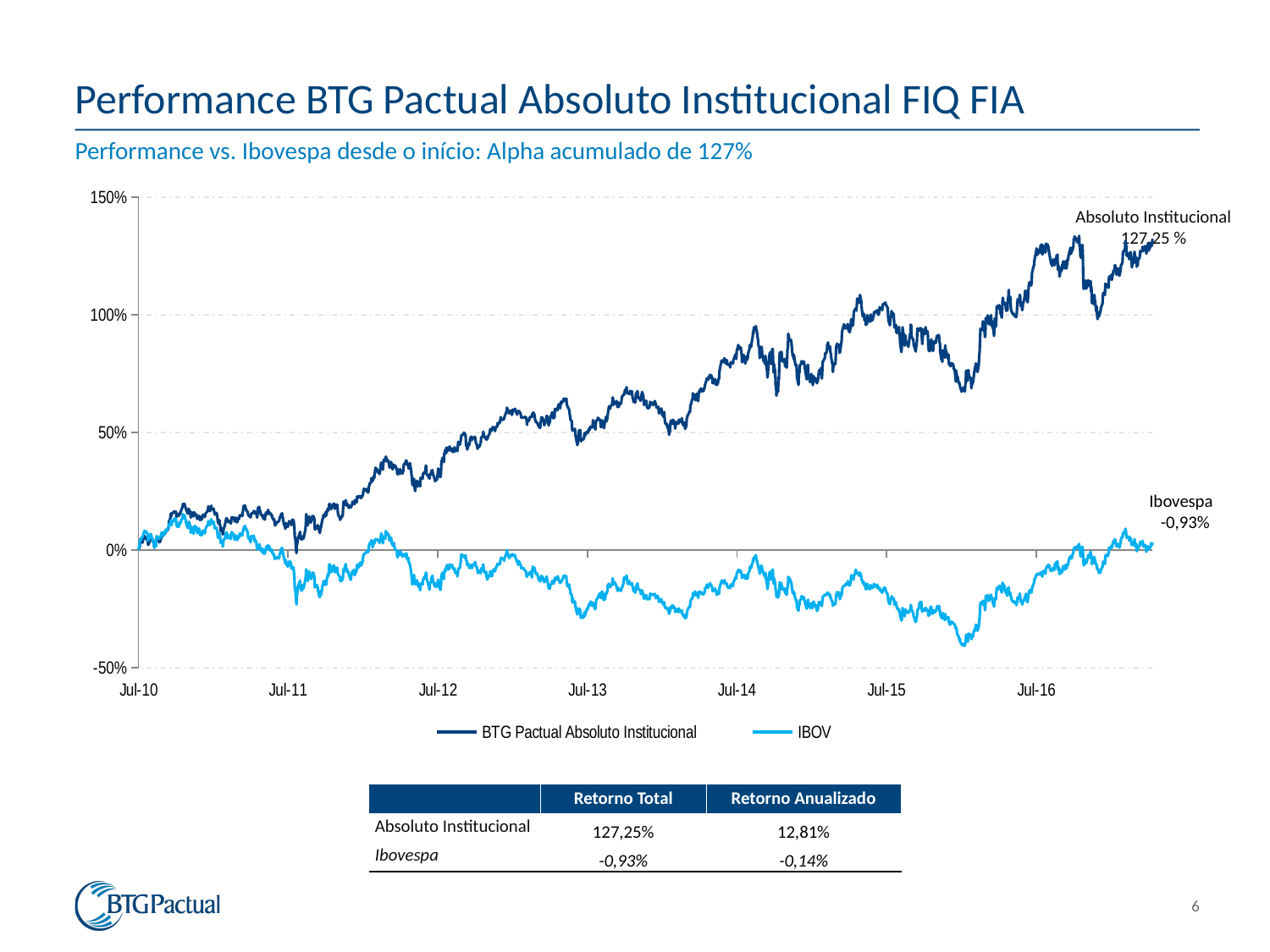
What is the final value shown for the Absoluto Institucional line? 127,25 % How many year labels are shown on the x axis? 7 What is the first date label on the x axis? Jul-10 Is the IBOV line around Jul-15 greater or less than 0%? less How many series does the chart legend list? 2 What is the final value shown for the Ibovespa line? -0,93% Does the BTG Pactual Absoluto Institucional line generally rise or fall from Jul-10 to the end of the chart? rise Is the final value of the BTG Pactual Absoluto Institucional line greater or less than 100%? greater What is the difference between the final values of Absoluto Institucional (127,25 %) and Ibovespa (-0,93%)? 128,18 percentage points What is the highest value shown on the y axis? 150% Which series ends higher at the right of the chart, BTG Pactual Absoluto Institucional or IBOV? BTG Pactual Absoluto Institucional What kind of chart is shown on the slide? line chart